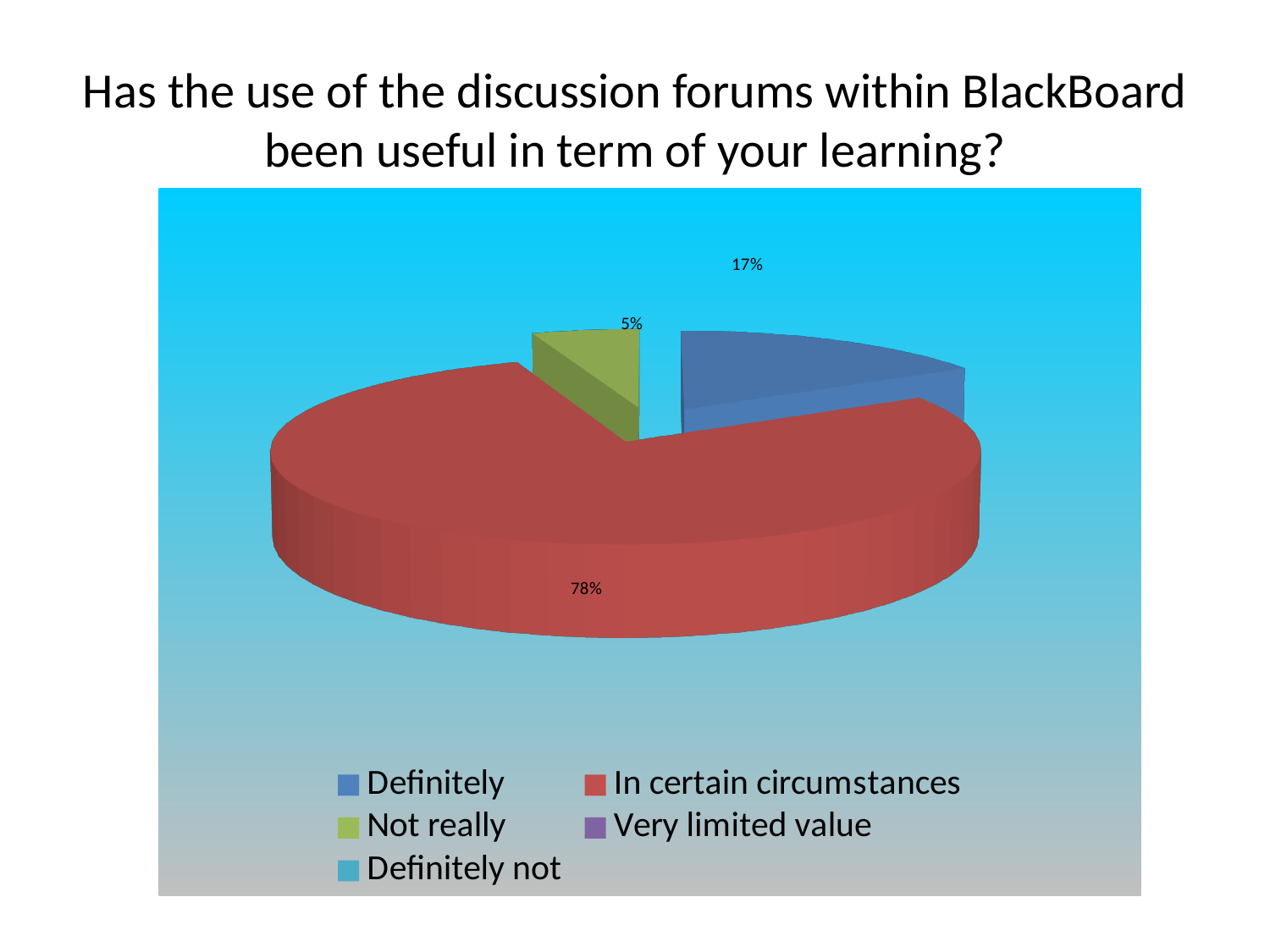
How many slices have a percentage label shown on the pie? 3 What kind of chart is shown on the slide? pie chart What is the difference in percentage points between "In certain circumstances" and "Definitely"? 61 What percentage of responses is "Definitely"? 17% Which of the labelled slices has the smallest share of the pie? Not really What percentage of responses is "In certain circumstances"? 78% Which response has the largest share of the pie? In certain circumstances Which is larger, the share for "Definitely" or the share for "Not really"? Definitely What percentage of responses is "Not really"? 5% What colour is the slice for "In certain circumstances"? red What is the difference in percentage points between "Definitely" and "Not really"? 12 How many entries does the legend list? 5